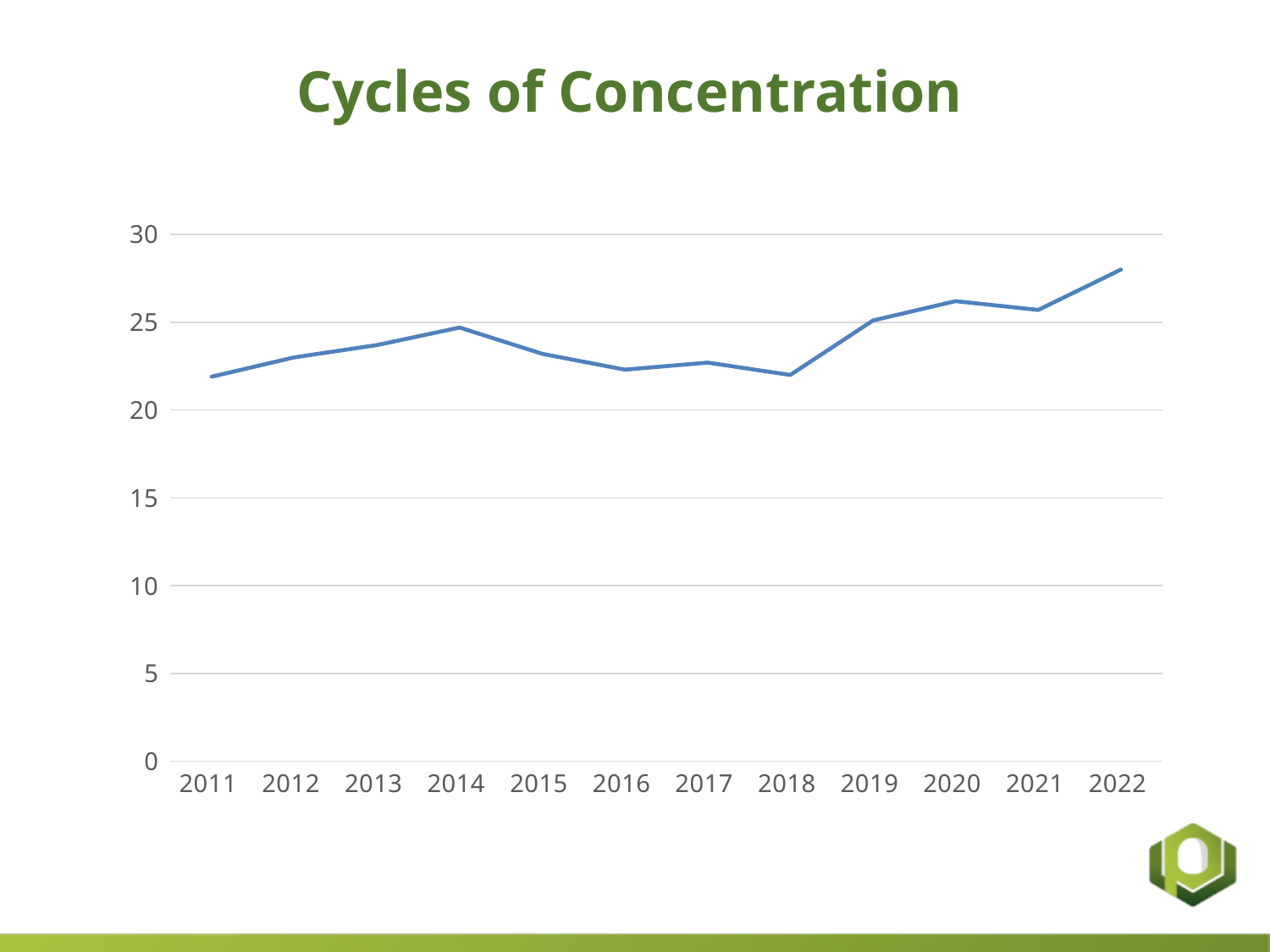
Is the value for 2011 greater or less than 25? less Is the value for 2022 greater or less than 25? greater Which is larger, the value for 2022 or the value for 2011? 2022 How many years are plotted along the x axis? 12 Is the value for 2018 greater or less than 20? greater What is the title of the chart? Cycles of Concentration Overall, does the value rise or fall from 2011 to 2022? rise Which year has the highest value? 2022 What kind of chart is shown on the slide? line chart Does the value rise or fall from 2014 to 2016? fall Which is larger, the value for 2019 or the value for 2018? 2019